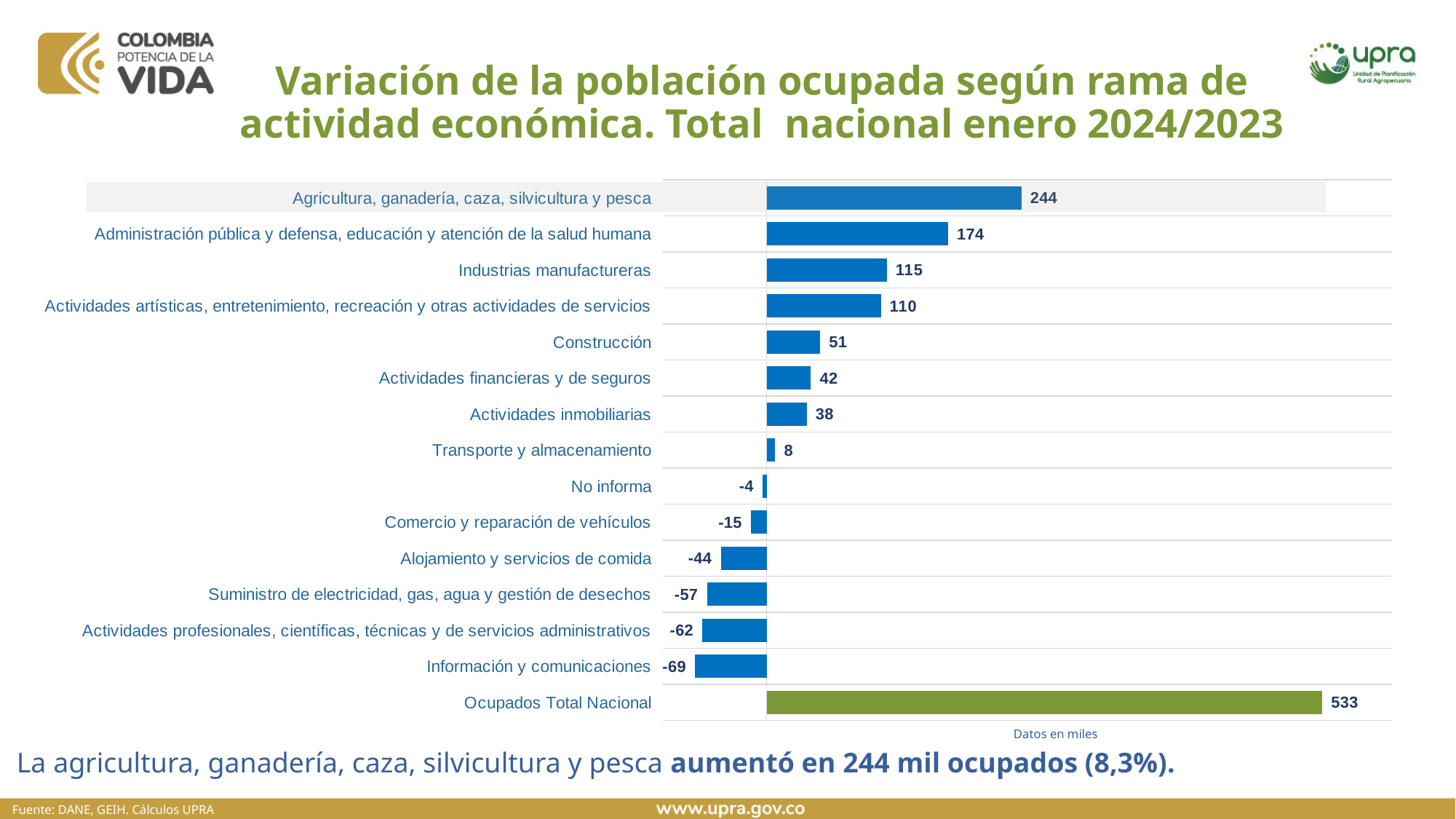
What is the value for Industrias manufactureras? 115 What is the value for Ocupados Total Nacional? 533 What type of chart is shown on the slide? Bar chart What is the value for Información y comunicaciones? -69 What is the difference between the values for Agricultura, ganadería, caza, silvicultura y pesca and Administración pública y defensa, educación y atención de la salud humana? 70 What unit note is printed below the chart? Datos en miles Excluding the Ocupados Total Nacional bar, which category has the highest value? Agricultura, ganadería, caza, silvicultura y pesca Which is larger, the value for Actividades financieras y de seguros or the value for Actividades inmobiliarias? Actividades financieras y de seguros Which category has the lowest value? Información y comunicaciones What is the value for Construcción? 51 How many categories are shown in the chart? 15 What is the difference between the values for Alojamiento y servicios de comida and Suministro de electricidad, gas, agua y gestión de desechos? 13